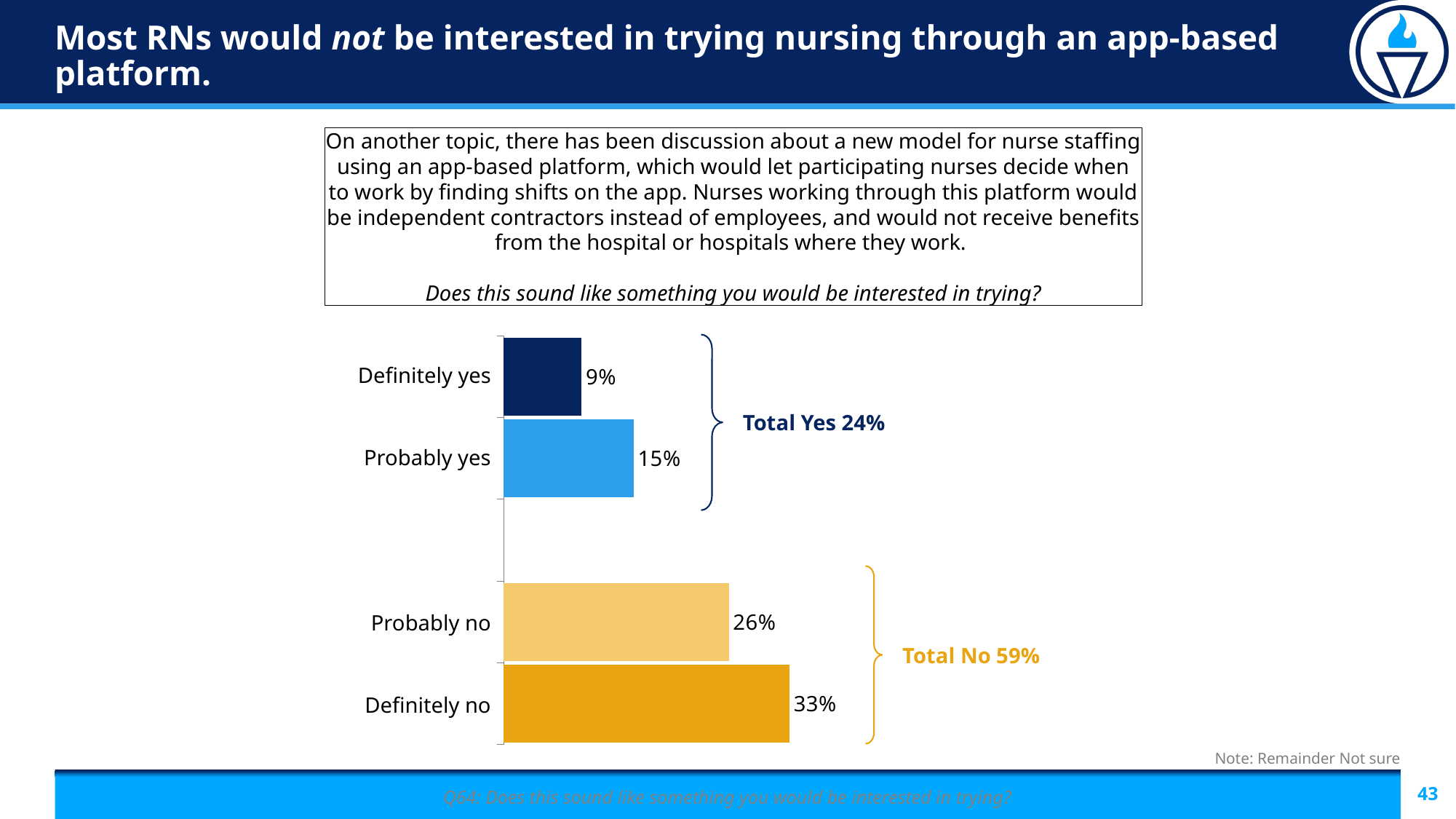
Which response category has the highest percentage? Definitely no Which response category has the lowest percentage? Definitely yes What percentage of RNs answered "Definitely yes"? 9% What percentage of RNs answered "Definitely no"? 33% What percentage of RNs answered "Probably yes"? 15% Which is larger, the percentage for "Probably no" or for "Probably yes"? Probably no What is the difference in percentage points between "Definitely no" and "Definitely yes"? 24 What is the Total No percentage shown next to the bracket? 59% How many response categories are shown in the chart? 4 What is the Total Yes percentage shown next to the bracket? 24% What percentage of RNs answered "Probably no"? 26% What kind of chart is shown on the slide? Bar chart